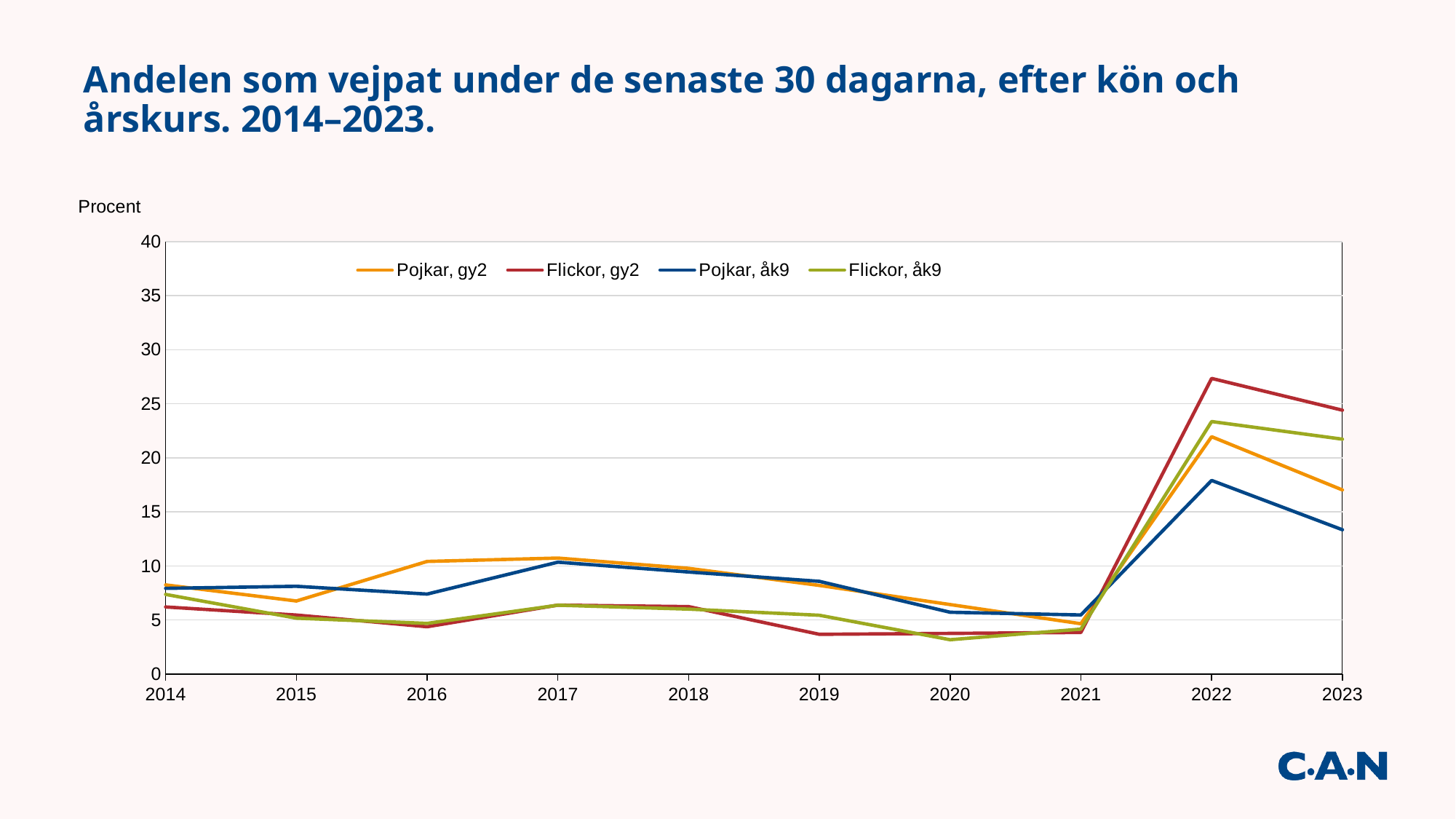
In which year does Flickor, gy2 reach its highest value? 2022 How many years are shown on the x axis? 10 How many series does the legend list? 4 In 2023, which is larger: Flickor, åk9 or Pojkar, gy2? Flickor, åk9 Does the value for Flickor, gy2 rise or fall from 2022 to 2023? fall Is the value for Flickor, gy2 in 2022 greater or less than 25? greater What is the label on the y axis of the chart? Procent Is the value for Pojkar, åk9 in 2023 greater or less than 15? less Is the value for Pojkar, gy2 in 2022 greater or less than 20? greater Which series has the highest value in 2022? Flickor, gy2 What kind of chart is shown on the slide? line chart Which series has the lowest value in 2023? Pojkar, åk9